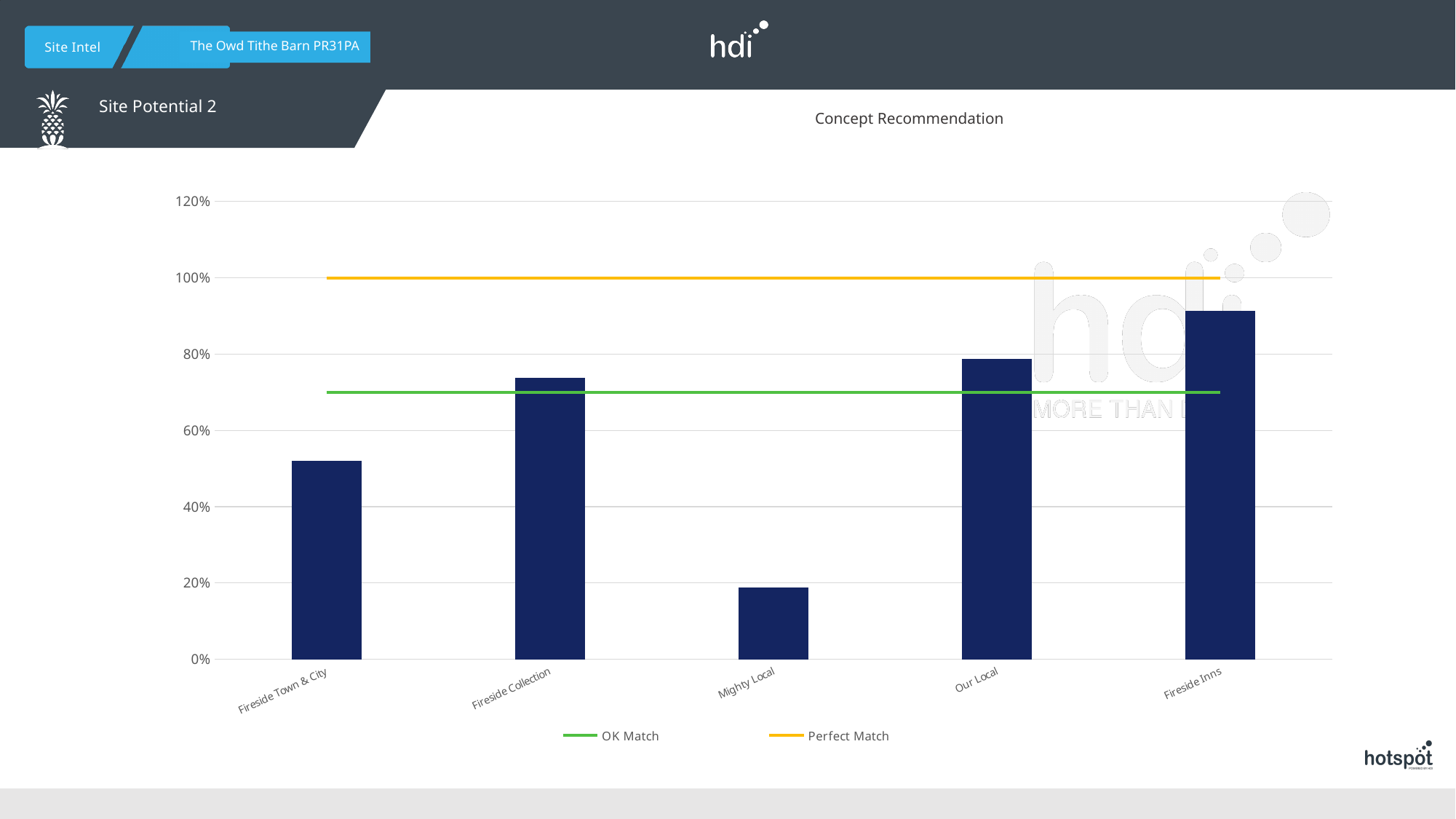
How many entries does the chart's legend list? 2 Is the value for Fireside Town & City greater or less than 60%? less Which category has the highest bar in the chart? Fireside Inns Is the value for Our Local greater or less than 60%? greater What kind of chart is shown on the slide? bar chart What is the title of the chart? Concept Recommendation Which category has the lowest bar in the chart? Mighty Local Is the value for Mighty Local greater or less than 20%? less Which is larger, the bar for Fireside Collection or the bar for Fireside Town & City? Fireside Collection What colour is the Perfect Match line in the chart? yellow How many categories are shown on the x axis of the chart? 5